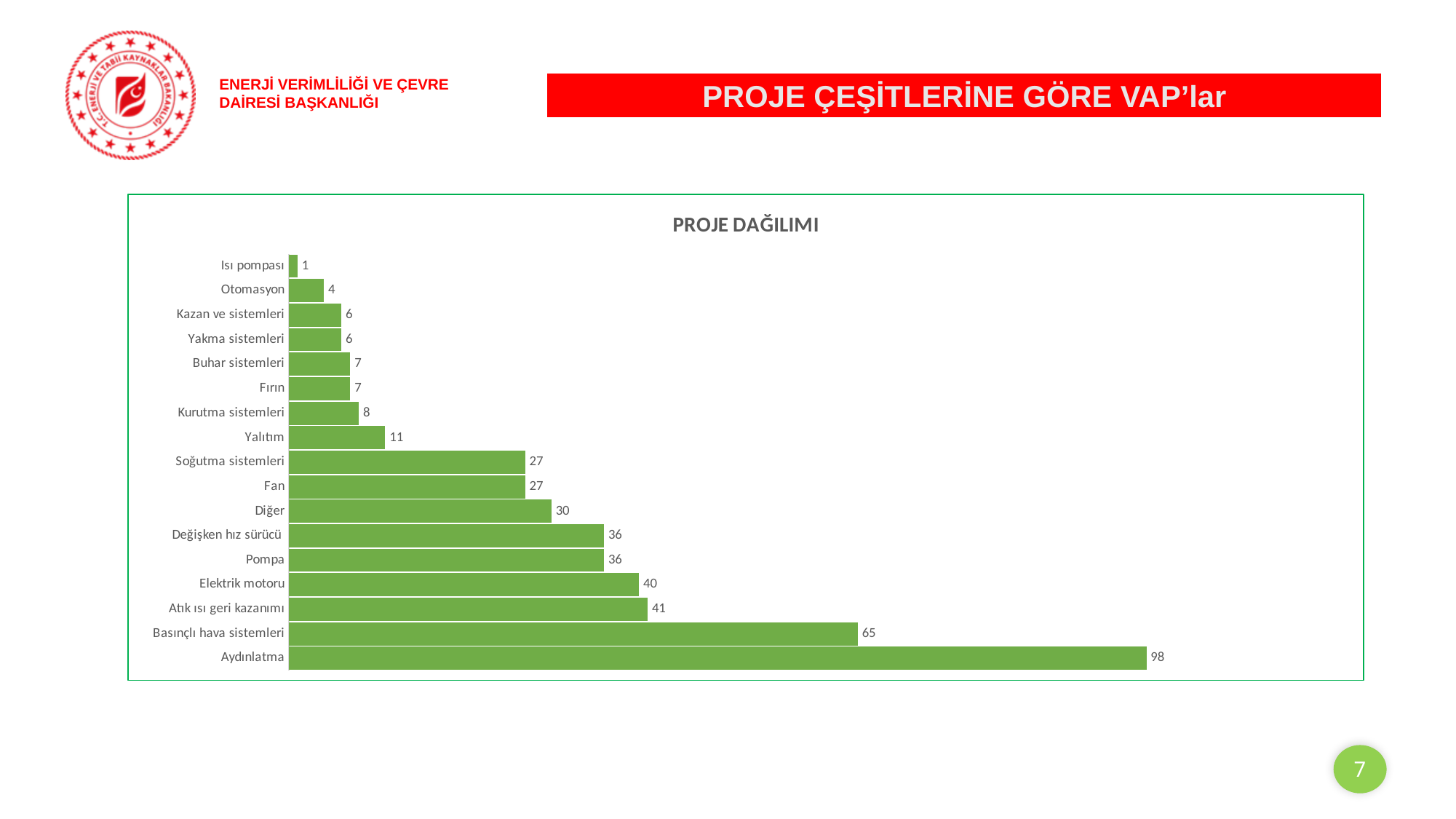
What is the value for Yalıtım? 11 Which category has the highest value? Aydınlatma What is the value for Basınçlı hava sistemleri? 65 What is the difference between the values for Aydınlatma and Basınçlı hava sistemleri? 33 What is the title of the chart? PROJE DAĞILIMI What is the difference between the values for Atık ısı geri kazanımı and Elektrik motoru? 1 What kind of chart is shown on the slide? Bar chart What is the value for Aydınlatma? 98 Which category has the lowest value? Isı pompası Which is larger, the value for Diğer or the value for Fan? Diğer What is the value for Kurutma sistemleri? 8 How many categories are shown in the chart? 17